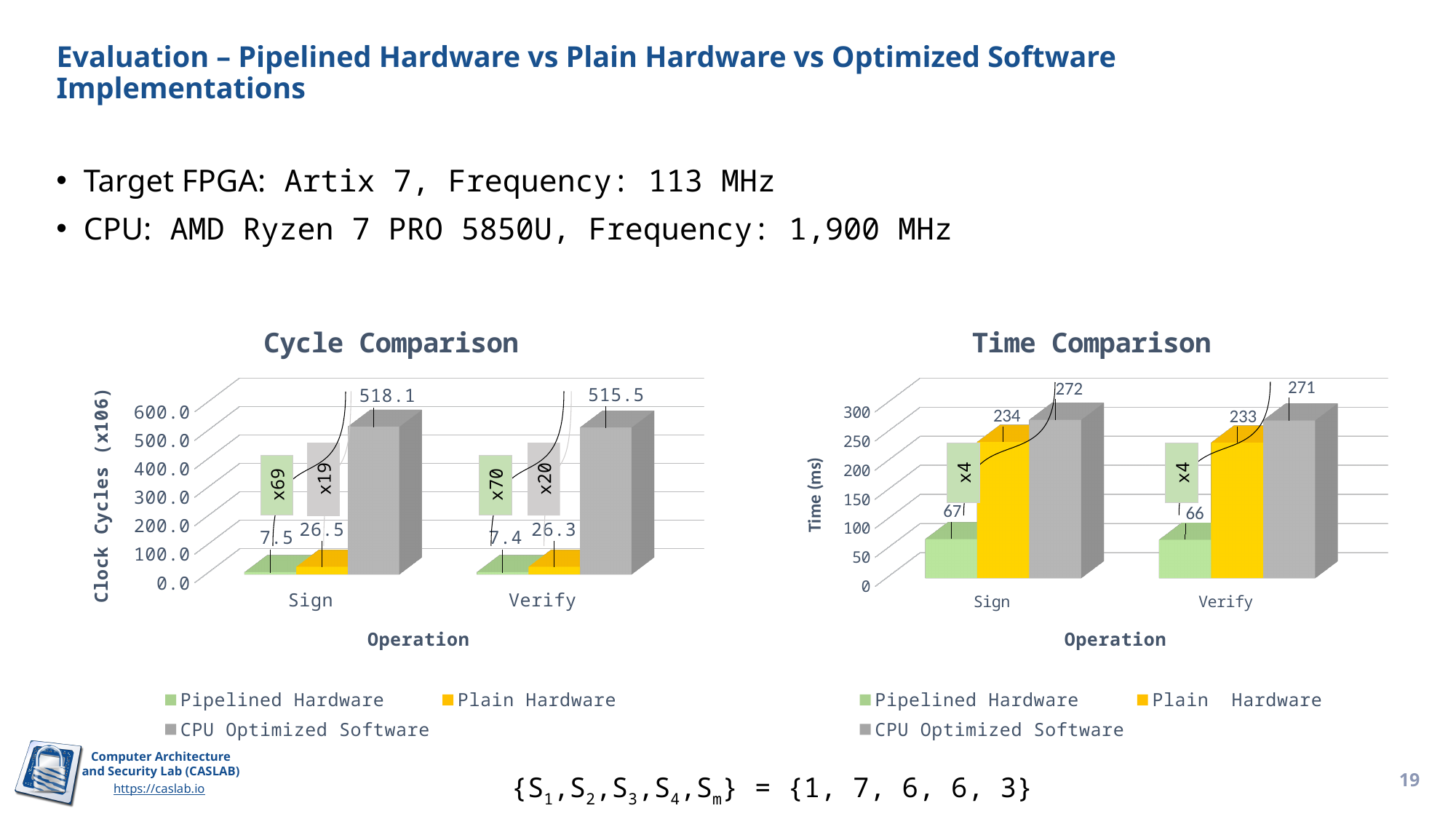
In the Time Comparison chart, what is the value for Plain Hardware for the Verify operation? 233 In the Time Comparison chart, which series has the highest value for the Sign operation? CPU Optimized Software In the Cycle Comparison chart, what is the difference between the Plain Hardware and Pipelined Hardware values for the Verify operation? 18.9 In the Time Comparison chart, what is the difference between the CPU Optimized Software and Plain Hardware values for the Sign operation? 38 What kind of chart is the Time Comparison chart? bar chart In the Cycle Comparison chart, what is the value for CPU Optimized Software for the Sign operation? 518.1 How many series does the legend of the Cycle Comparison chart list? 3 In the Time Comparison chart, is the CPU Optimized Software value for Verify larger or smaller than the CPU Optimized Software value for Sign? smaller In the Time Comparison chart, what is the value for Pipelined Hardware for the Sign operation? 67 In the Cycle Comparison chart, what is the value for Plain Hardware for the Sign operation? 26.5 In the Cycle Comparison chart, what is the value for Pipelined Hardware for the Verify operation? 7.4 In the Cycle Comparison chart, which series has the lowest value for the Verify operation? Pipelined Hardware